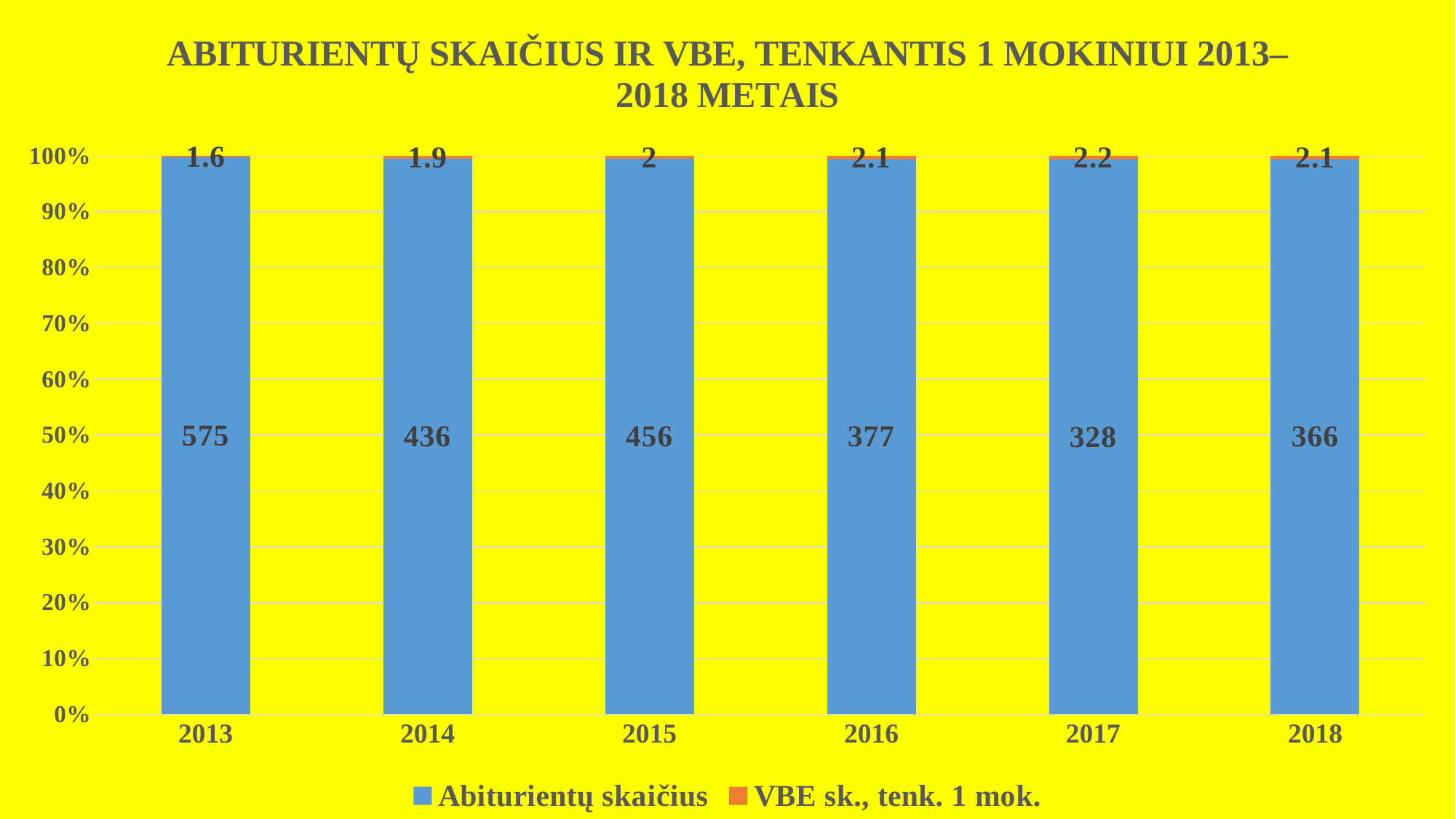
How many series does the legend list? 2 Which year has the lowest value for VBE sk., tenk. 1 mok.? 2013 What is the value of Abiturientų skaičius for 2013? 575 What is the value of VBE sk., tenk. 1 mok. for 2015? 2 What is the difference between the Abiturientų skaičius values for 2013 and 2014? 139 Which year has the highest value for Abiturientų skaičius? 2013 What kind of chart is shown on the slide? Stacked bar chart What is the value of VBE sk., tenk. 1 mok. for 2017? 2.2 Which year has the lowest value for Abiturientų skaičius? 2017 What is the value of Abiturientų skaičius for 2018? 366 Which is larger, the Abiturientų skaičius value for 2015 or for 2016? 2015 How many years are shown on the x axis? 6